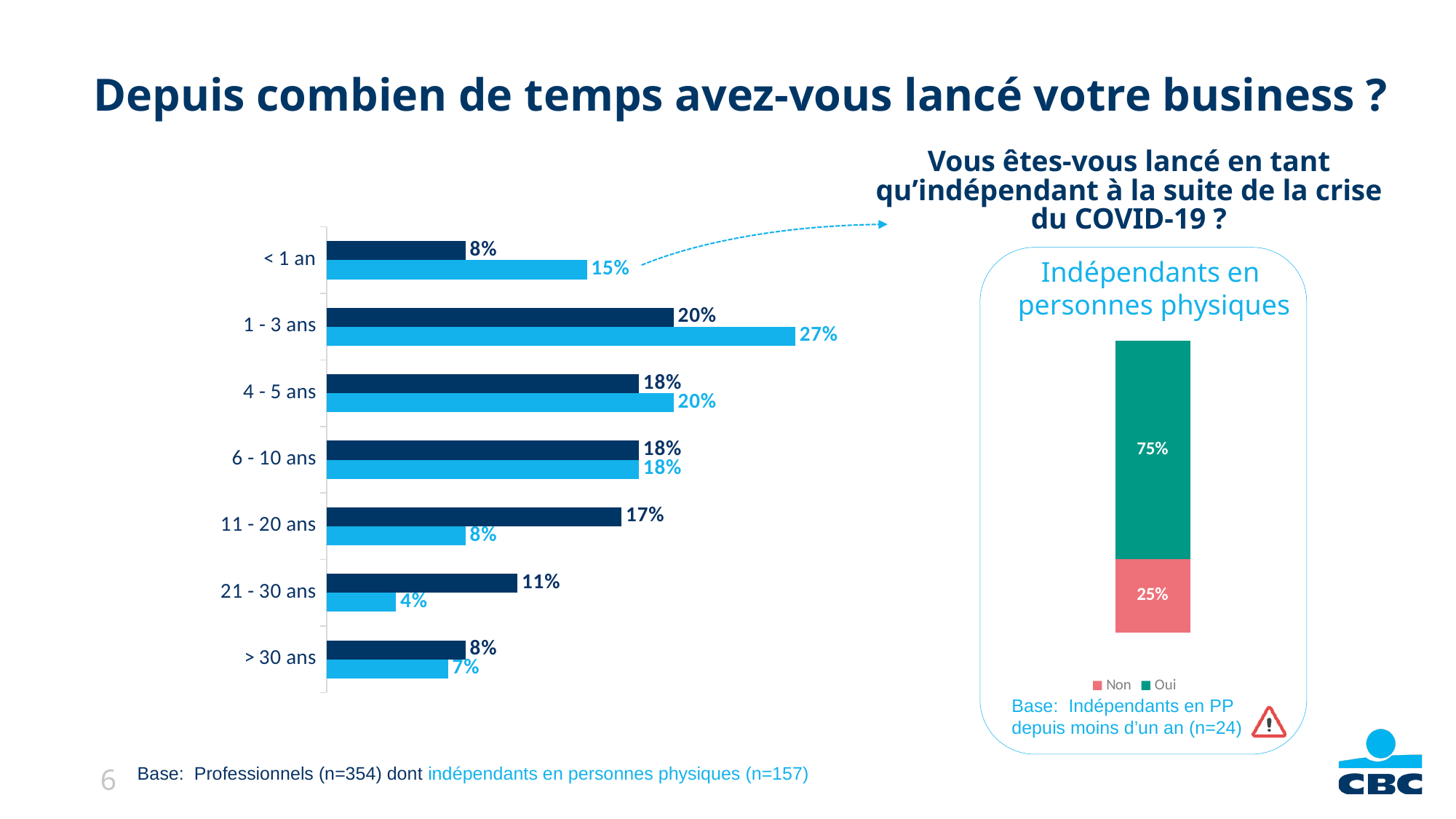
In the left bar chart, what is the value of the light blue bar for '21 - 30 ans'? 4% What type of chart is the chart on the left of the slide? bar chart In the left bar chart, for '11 - 20 ans', which bar is larger, the dark blue or the light blue? dark blue How many series does the legend of the right chart 'Indépendants en personnes physiques' list? 2 In the right chart 'Indépendants en personnes physiques', what is the total of the stacked bar? 100% In the left bar chart, which category has the lowest light blue value? 21 - 30 ans In the left bar chart, what is the difference between the light blue and dark blue values for '< 1 an'? 7% In the left bar chart, what is the value of the light blue bar for '1 - 3 ans'? 27% In the left bar chart, what is the value of the dark blue bar for '11 - 20 ans'? 17% How many categories does the left bar chart show? 7 In the right chart 'Indépendants en personnes physiques', what is the value for 'Oui'? 75% In the left bar chart, which category has the highest light blue value? 1 - 3 ans